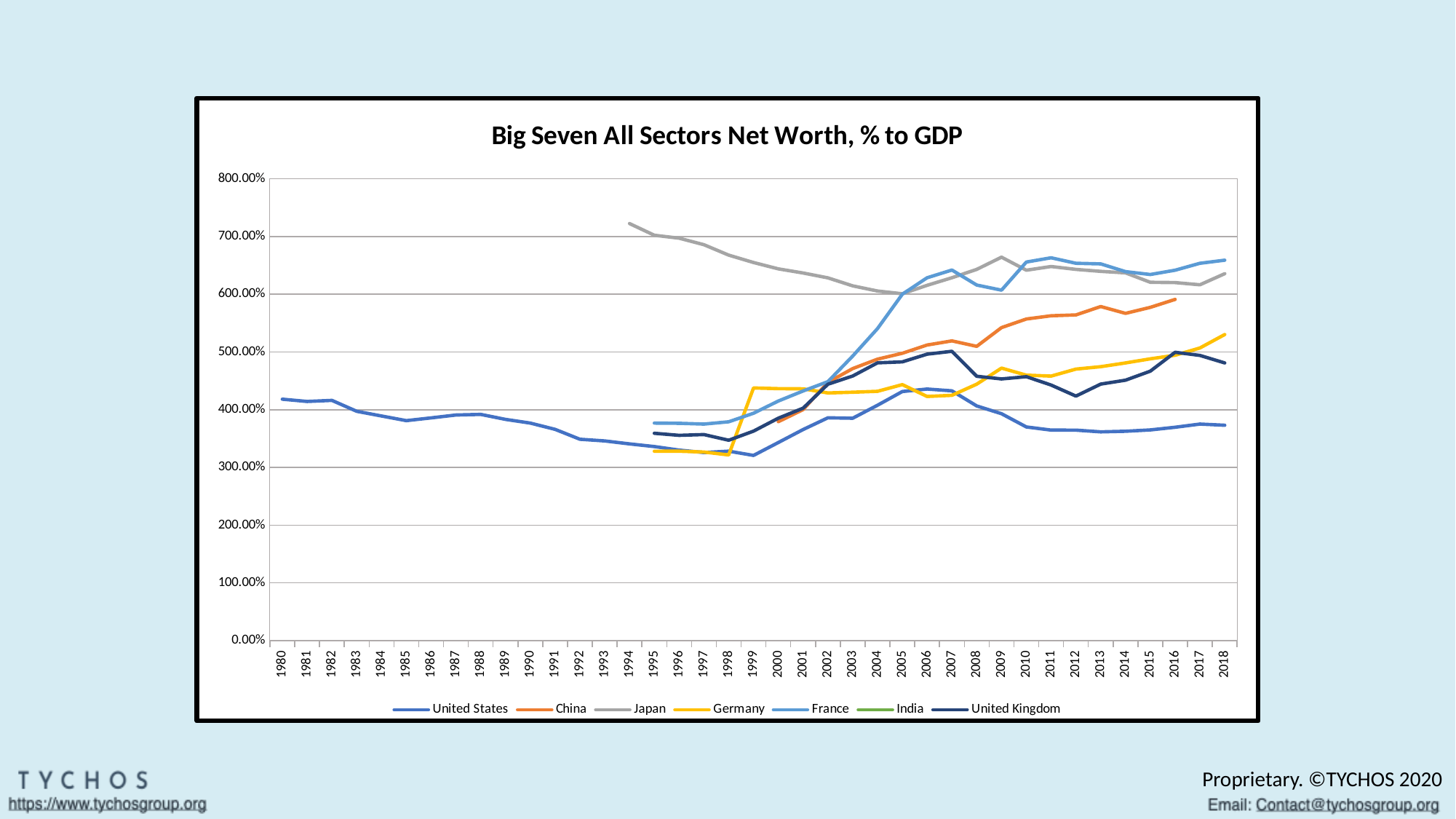
What kind of chart is shown on the slide? line chart Is the value for France in 2018 greater or less than 600.00%? greater Which series has the lowest value in 2018? United States Is the value for Japan in 1994 greater or less than 700.00%? greater Which is larger in 2018, the value for France or the value for the United States? France Does the China line rise or fall from 2000 to 2016? rise What is the title of the chart? Big Seven All Sectors Net Worth, % to GDP Which series has the highest value in 1994? Japan Is the value for the United Kingdom in 2018 greater or less than 500.00%? less Does the United States line rise or fall from 1980 to 1999? fall How many series does the legend list? 7